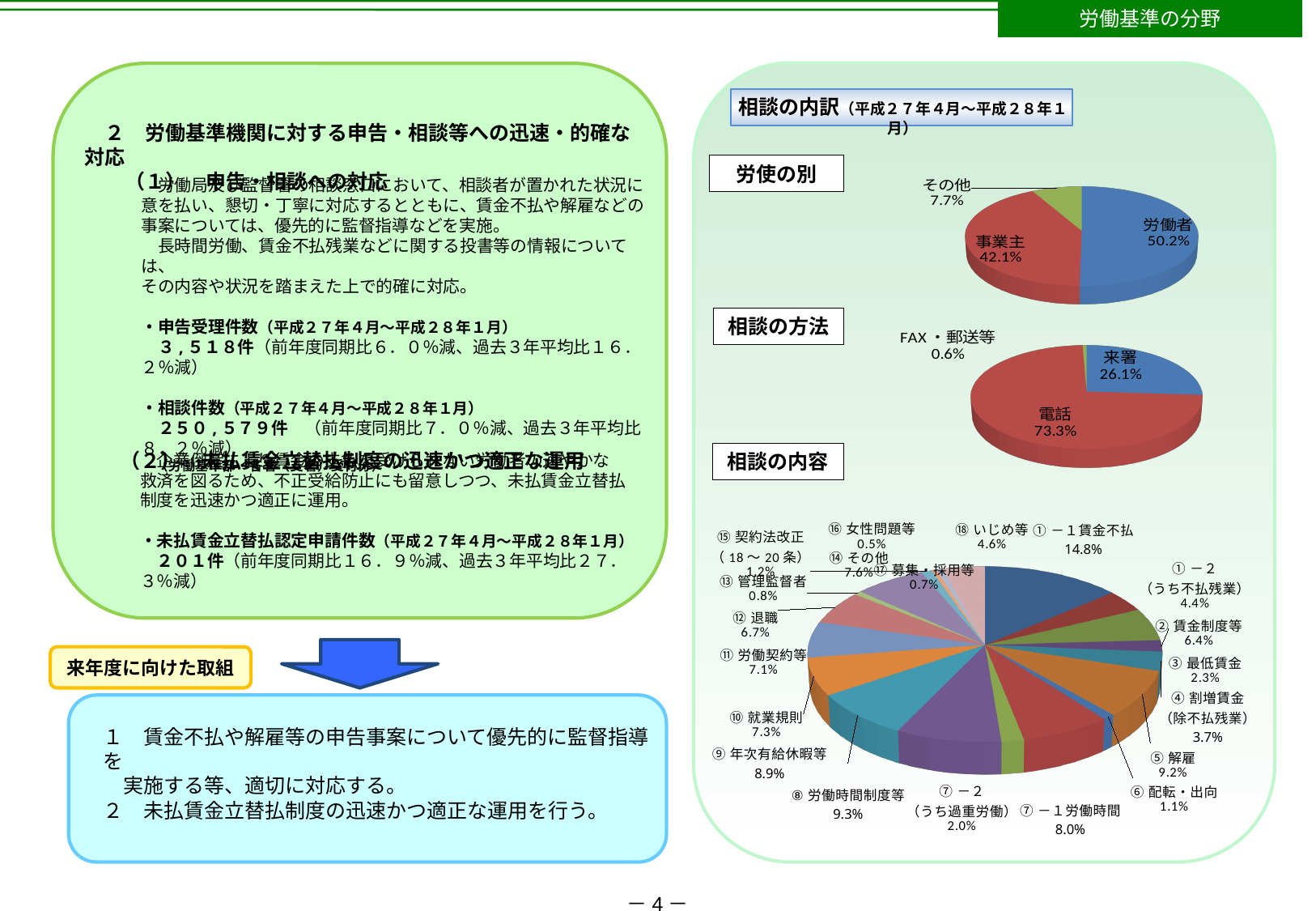
In the 労使の別 pie chart, how many slices are there? 3 In the 相談の方法 pie chart, which category is the smallest? FAX・郵送等 In the 労使の別 pie chart, what share is 事業主? 42.1% In the 労使の別 pie chart, what is the difference between 労働者 and 事業主? 8.1% In the 相談の内容 pie chart, what share is ⑨ 年次有給休暇等? 8.9% In the 相談の内容 pie chart, what share is ⑤ 解雇? 9.2% In the 相談の方法 pie chart, what share is 電話? 73.3% In the 相談の内容 pie chart, which category has the largest share? ①－1 賃金不払 In the 相談の内容 pie chart, which is larger, ⑩ 就業規則 or ⑫ 退職? ⑩ 就業規則 What kind of chart is used for 相談の内容? pie chart In the 相談の方法 pie chart, which is larger, 来署 or 電話? 電話 In the 労使の別 pie chart, what share is 労働者? 50.2%